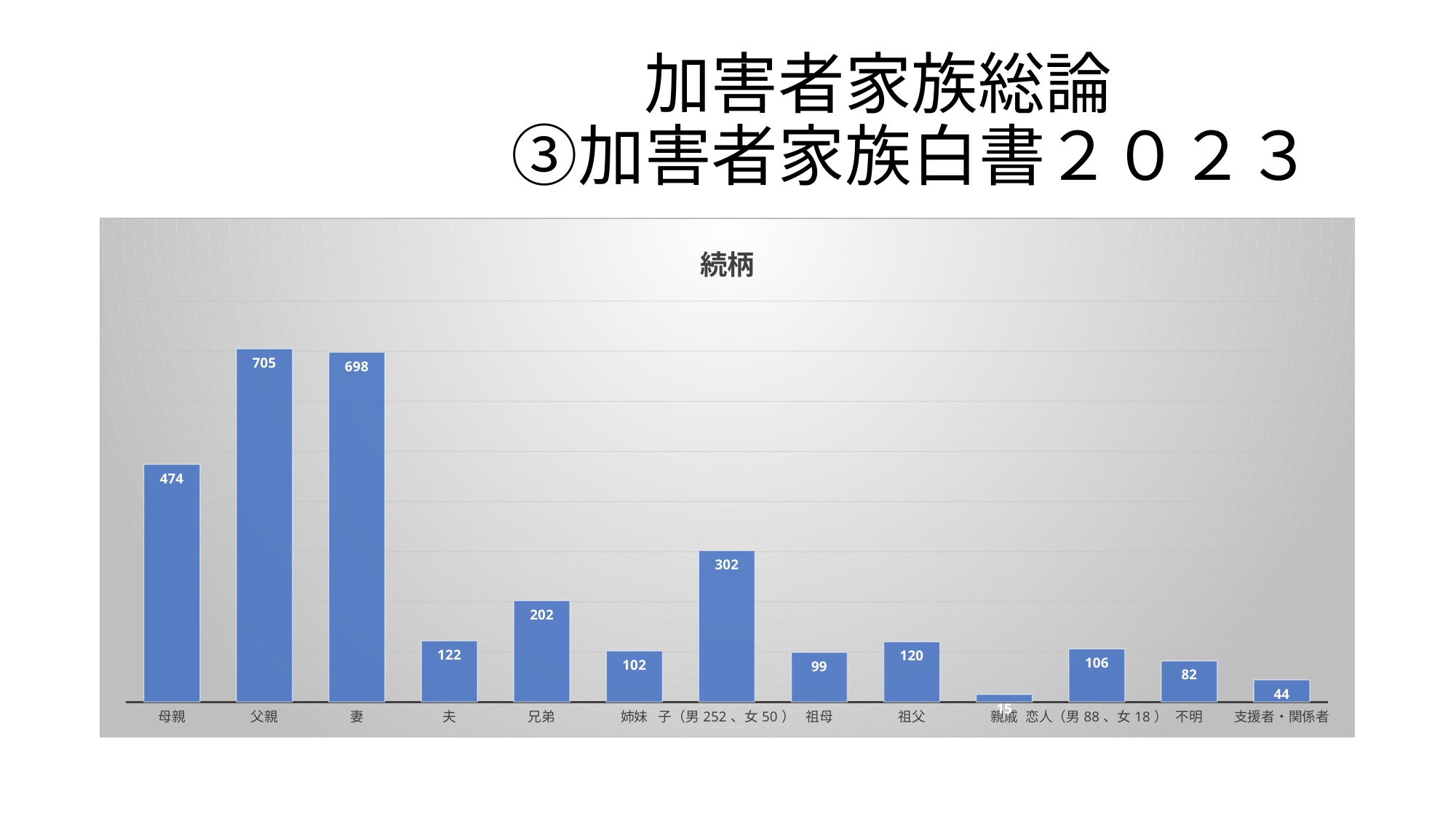
Which category has the lowest value? 親戚 What is the value for 母親? 474 Which is larger, the value for 兄弟 or the value for 夫? 兄弟 Which category has the highest value? 父親 How many categories are shown on the x axis? 13 What is the value for 支援者・関係者? 44 What is the difference between the values for 父親 and 妻? 7 What is the value for 妻? 698 What type of chart is shown on the slide? bar chart What is the difference between the values for 祖父 and 祖母? 21 What is the title of the chart? 続柄 What is the value for 子（男252、女50）? 302